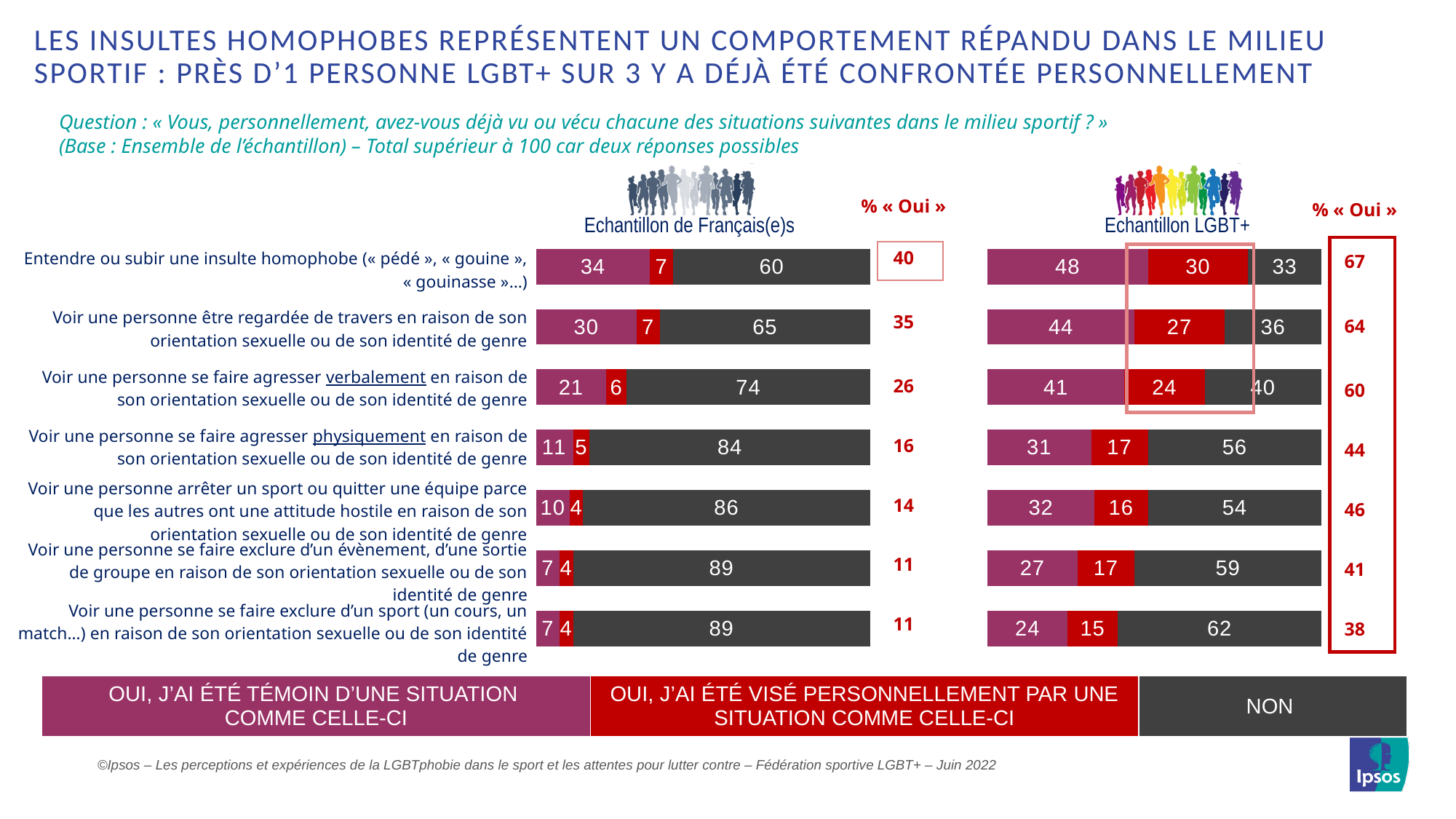
How many categories are shown in the "Echantillon de Français(e)s" chart? 7 What kind of chart is the "Echantillon LGBT+" chart? Stacked bar chart In the "Echantillon LGBT+" chart, what is the difference between the "NON" values for "Voir une personne se faire exclure d'un sport" and "Entendre ou subir une insulte homophobe"? 29 How many series does the legend list for the charts? 3 In the "Echantillon LGBT+" chart, what is the "NON" value for "Entendre ou subir une insulte homophobe"? 33 In the "Echantillon de Français(e)s" chart, which category has the highest "NON" value? Voir une personne se faire exclure d'un évènement / d'un sport (89) Is the "Oui, j'ai été témoin" value for "Voir une personne se faire agresser verbalement" larger in the "Echantillon de Français(e)s" chart or the "Echantillon LGBT+" chart? Echantillon LGBT+ What is the "% « Oui »" total for "Voir une personne se faire agresser physiquement" in the "Echantillon LGBT+" chart? 44 Which colour represents "NON" in the charts? Dark grey In the "Echantillon de Français(e)s" chart, what is the "Oui, j'ai été témoin" value for "Voir une personne être regardée de travers"? 30 In the "Echantillon LGBT+" chart, which category has the lowest "Oui, j'ai été témoin" value? Voir une personne se faire exclure d'un sport (24) In the "Echantillon LGBT+" chart, what is the "Oui, j'ai été visé personnellement" value for "Voir une personne se faire agresser physiquement"? 17